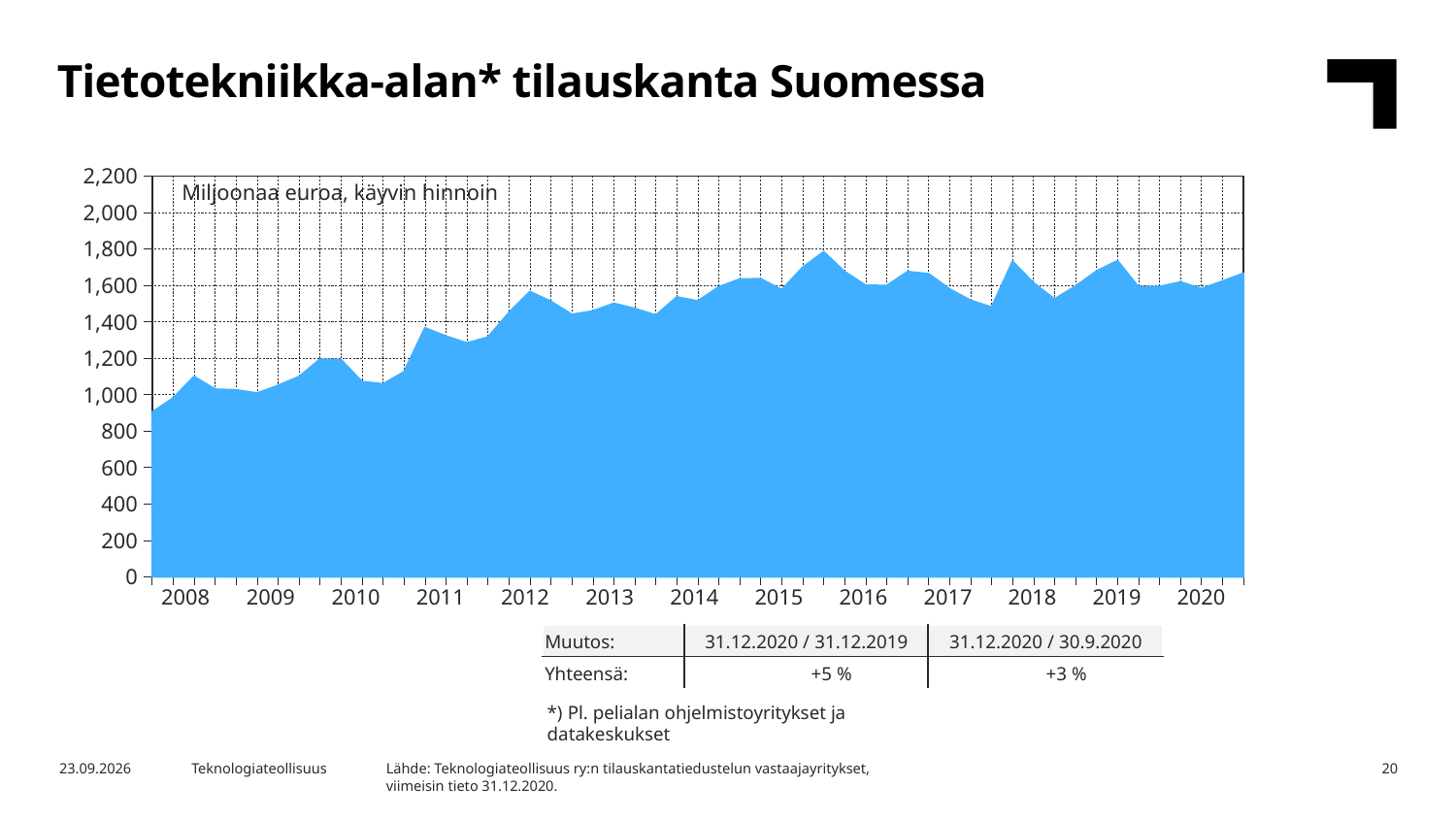
Is the value at the end of 2020 greater or less than 1,400? greater Which year is the first on the x axis? 2008 Is the value at the start of 2008 greater or less than 1,000? less Overall, do the values rise or fall from 2008 to 2020? rise What kind of chart is shown on the slide? area chart What is the title of the chart? Tietotekniikka-alan* tilauskanta Suomessa How many year labels are shown on the x axis? 13 Is the highest value in 2015 greater or less than 1,600? greater Which year contains the lowest value on the chart? 2008 What unit is stated inside the chart area? Miljoonaa euroa, käyvin hinnoin Which year is the last on the x axis? 2020